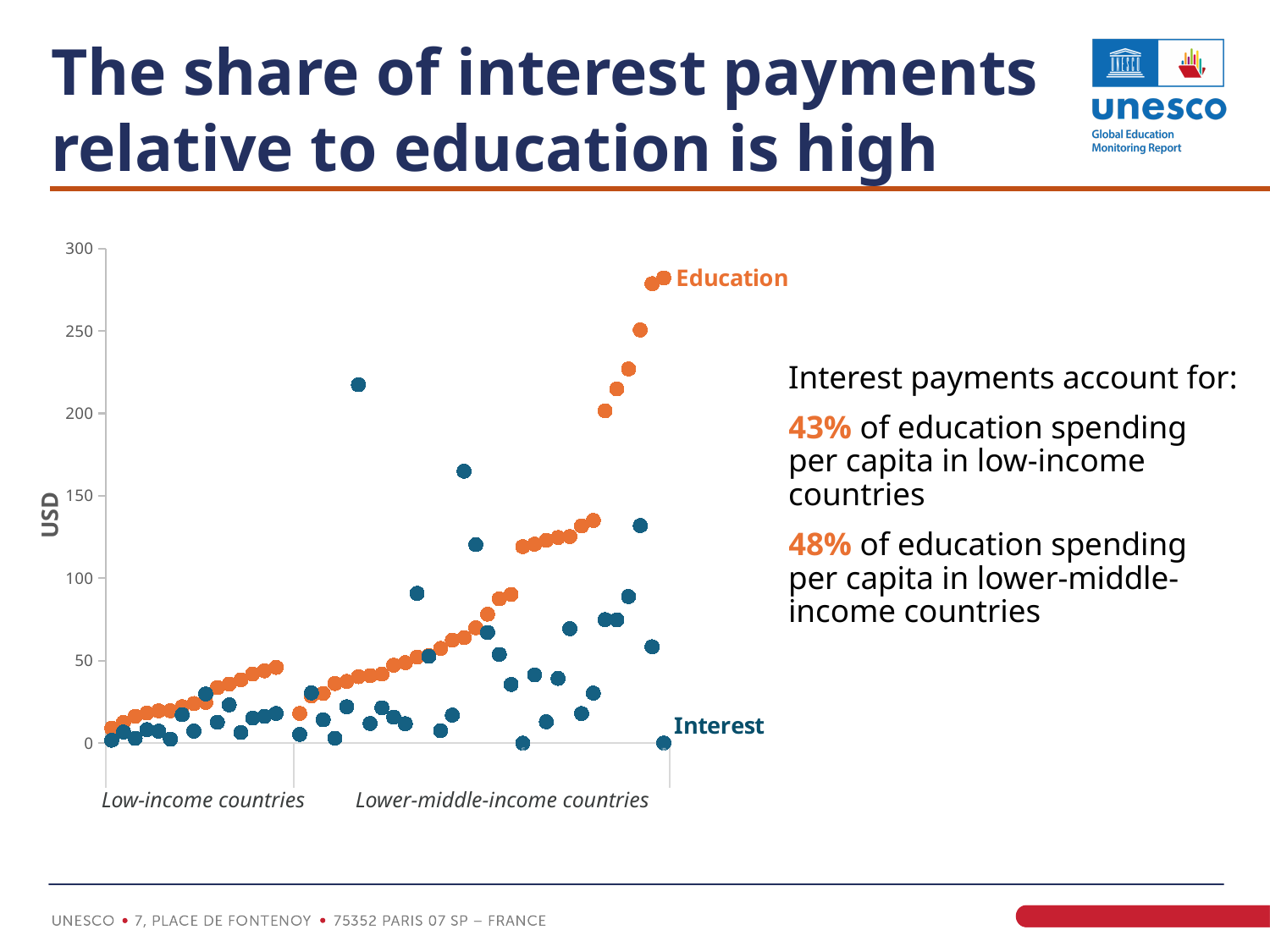
How many country income groups are labelled along the x axis of the chart? 2 Do the Education values rise or fall from left to right within each income group in the chart? rise How many series are plotted in the chart? 2 What is the label on the vertical axis of the chart? USD Is the highest Interest value in the chart greater or less than 200? greater What are the names of the two series plotted in the chart? Education and Interest What is the maximum value shown on the vertical axis of the chart? 300 Which income group in the chart contains the highest Education value? Lower-middle-income countries What kind of chart is shown on the slide? Scatter chart Is the highest Education value in the chart greater or less than 250? greater Are all Education values for low-income countries greater or less than 100? less Which series, Education or Interest, reaches the highest value in the chart? Education